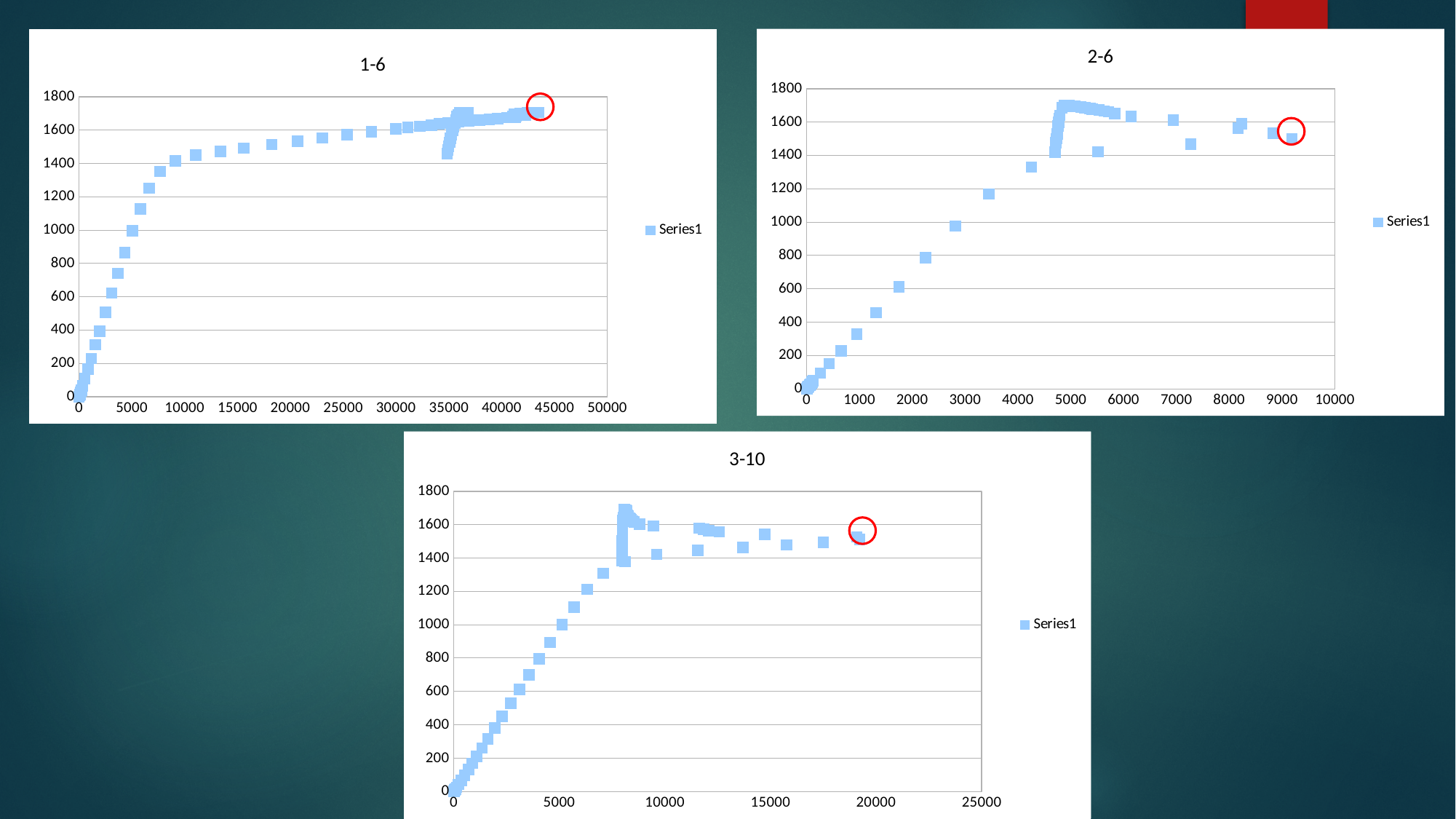
What is the title of the chart at the bottom of the slide? 3-10 What is the name of the series shown in the legend of the chart titled "3-10"? Series1 What kind of chart is the chart titled "1-6"? scatter chart How many charts are shown on the slide? 3 In the chart titled "1-6", is the value of the circled point greater or less than 1600? greater In the chart titled "1-6", do the values generally rise or fall as the x axis increases? rise In the chart titled "3-10", is the value of the point at x = 5000 greater or less than 1200? less In the chart titled "3-10", is the value of the circled point greater or less than 1600? less How many series does the legend of the chart titled "2-6" list? 1 What is the highest value shown on the x axis of the chart titled "1-6"? 50000